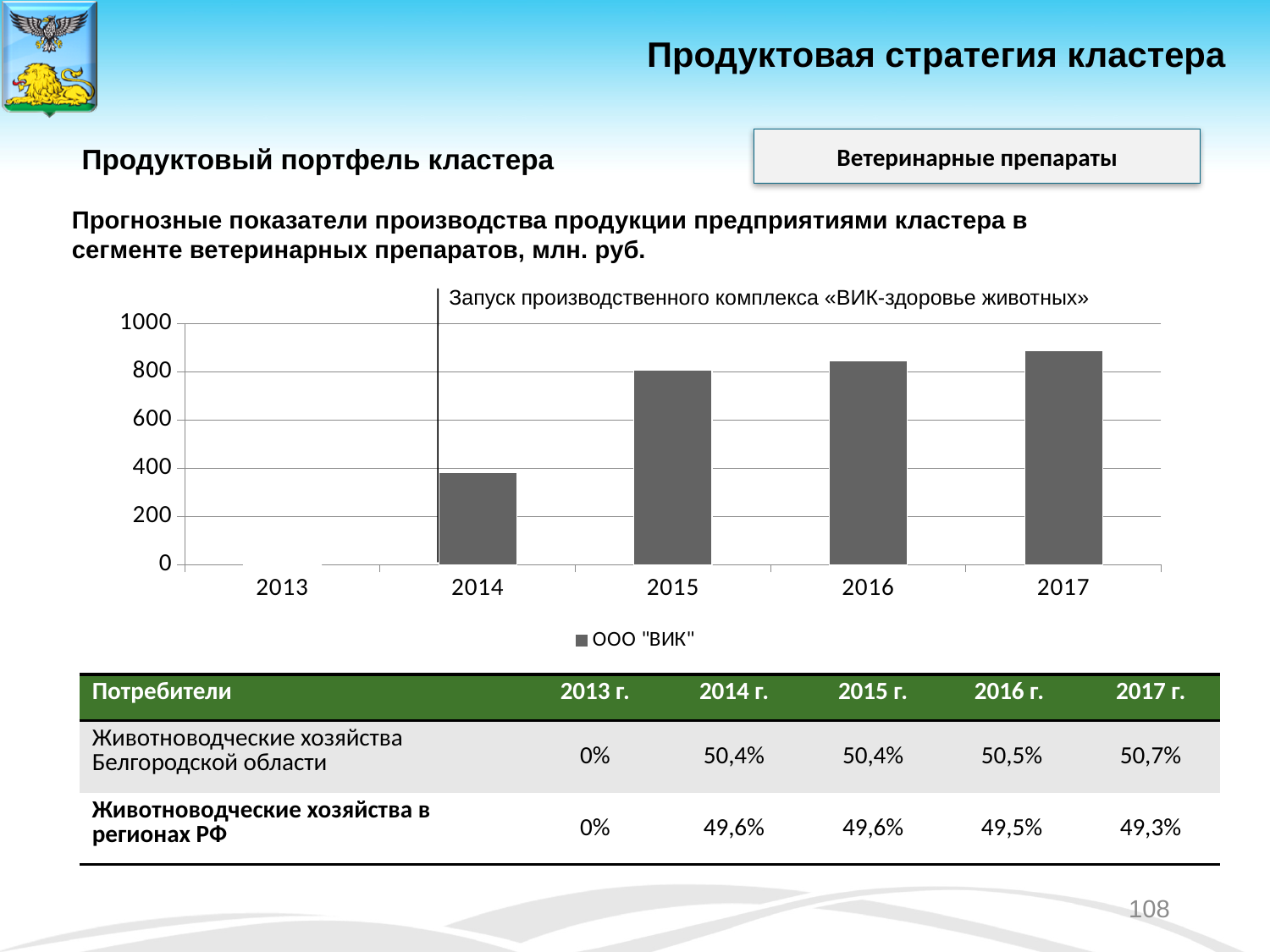
Which year has the lowest value in the chart? 2013 Is the value for 2016 greater or less than 800? greater Is the value for 2014 greater or less than 200? greater How many years are shown on the x axis of the chart? 5 Which year has the highest bar in the chart? 2017 Is the value for 2015 greater or less than 600? greater Which year has the larger value, 2014 or 2015? 2015 What is the name of the series shown in the chart legend? ООО "ВИК" How many series does the chart legend list? 1 What kind of chart is shown on the slide? bar chart Do the values in the chart rise or fall from 2013 to 2017? rise